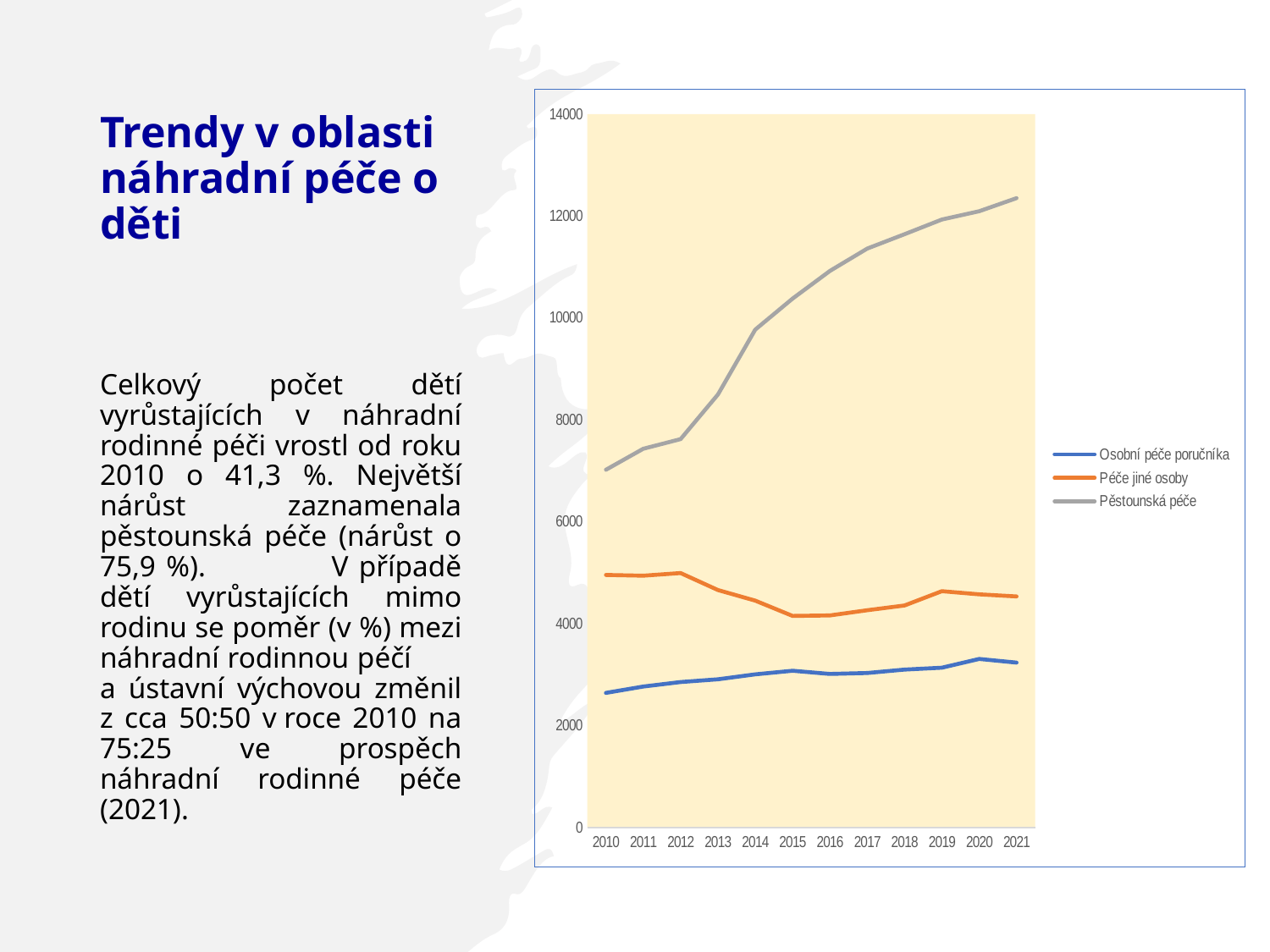
What kind of chart is shown on the slide? line chart Is the value for Péče jiné osoby in 2012 greater or less than 4000? greater Is the value for Osobní péče poručníka in 2010 greater or less than 4000? less Does the value for Pěstounská péče rise or fall from 2010 to 2021? rise Which series has the lowest value in 2010? Osobní péče poručníka In 2021, which is larger: Péče jiné osoby or Osobní péče poručníka? Péče jiné osoby How many series does the chart legend list? 3 What colour is the line for Pěstounská péče? gray Which series has the highest value in 2021? Pěstounská péče Is the value for Pěstounská péče in 2010 greater or less than 8000? less How many years are shown on the x axis of the chart? 12